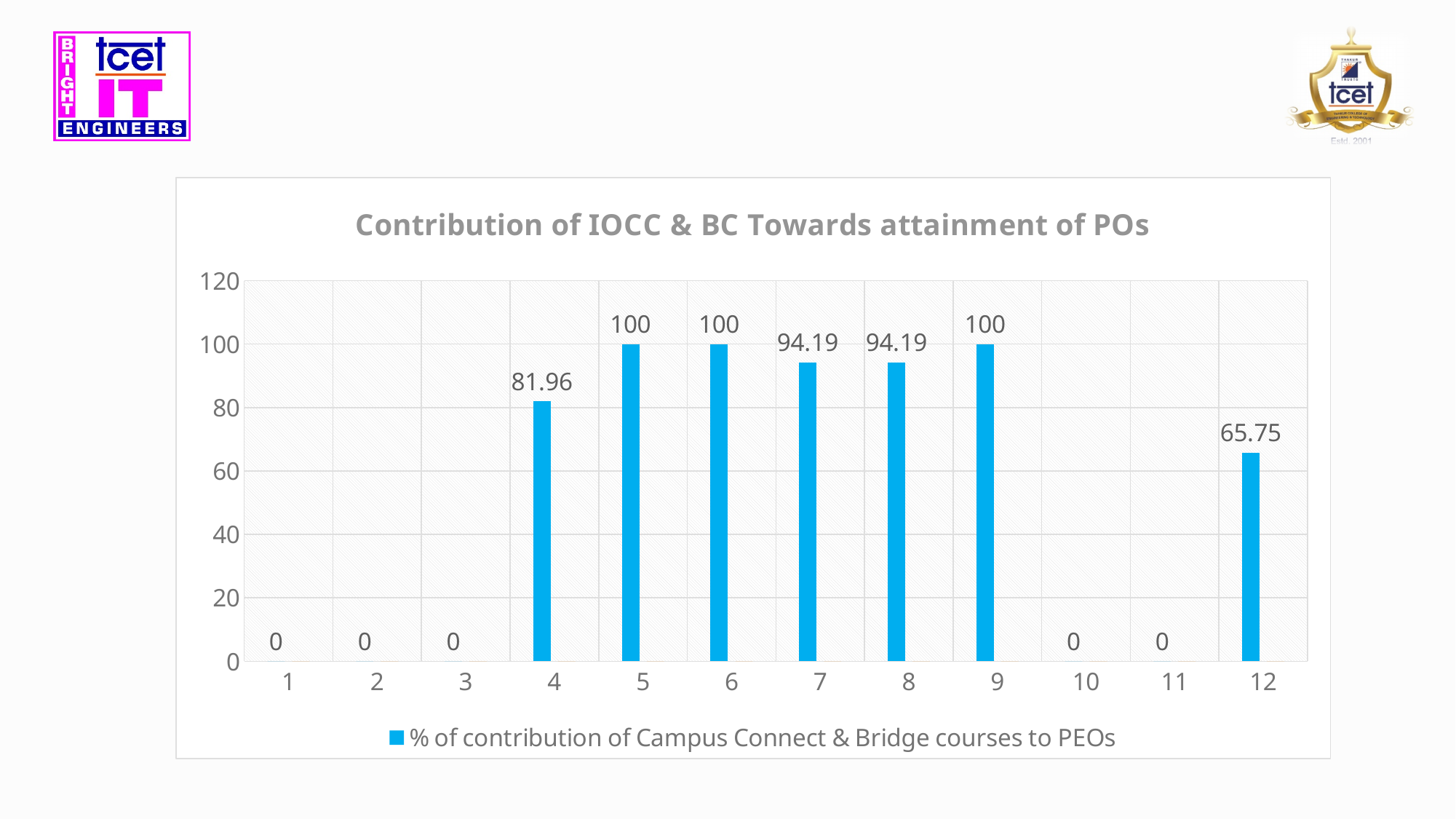
What is the value for category 12? 65.75 Which categories have the highest value? 5, 6 and 9 What is the difference between the values for category 5 and category 12? 34.25 Which is larger, the value for category 4 or the value for category 8? Category 8 What is the value for category 10? 0 Is the value for category 12 greater or less than 80? less What is the title of the chart? Contribution of IOCC & BC Towards attainment of POs How many categories are shown on the x axis? 12 What is the difference between the values for category 7 and category 4? 12.23 What is the value for category 7? 94.19 What kind of chart is shown? Bar chart What is the value for category 4? 81.96